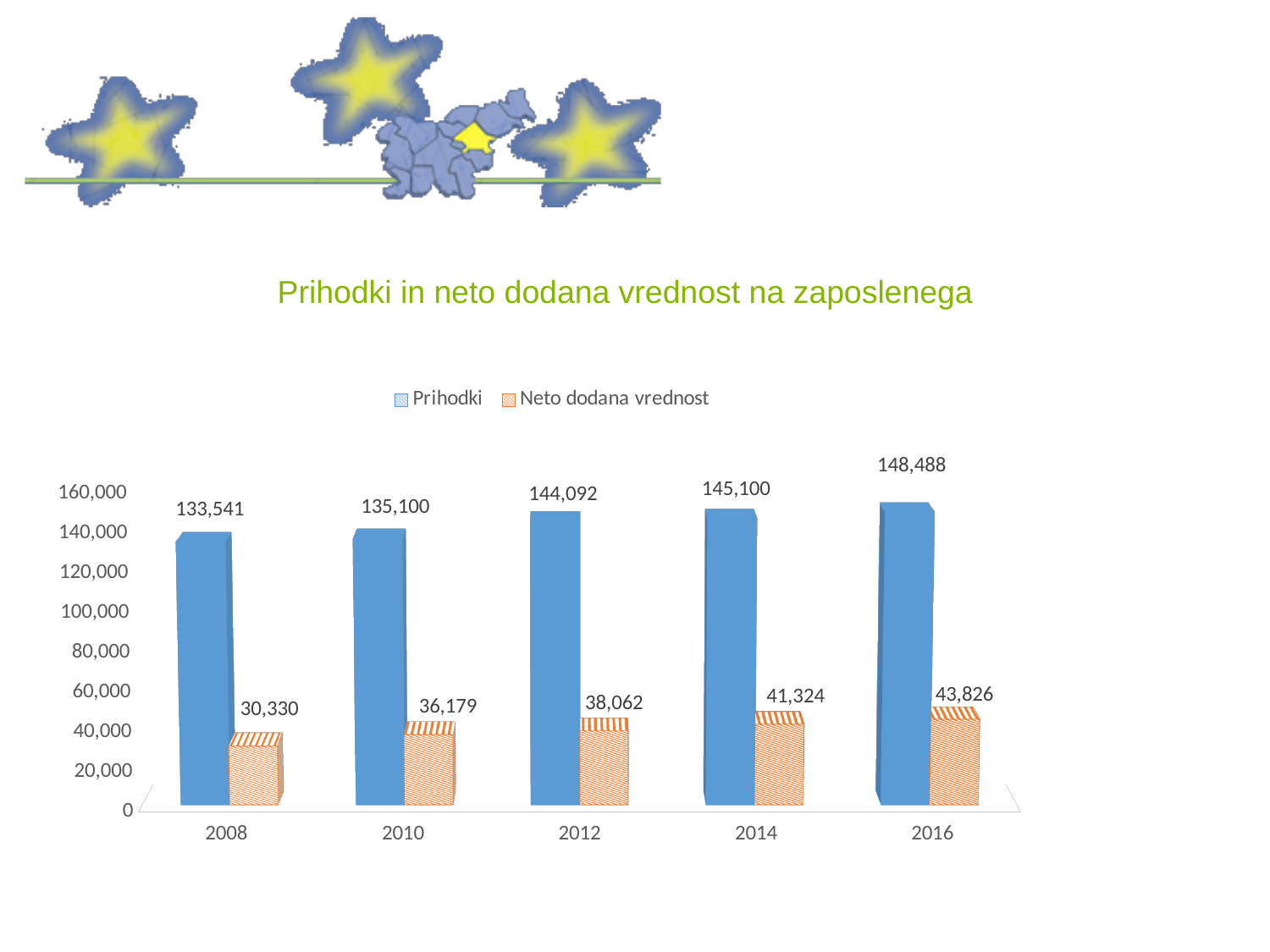
Do the Neto dodana vrednost values rise or fall from 2008 to 2016? Rise Which year has the highest Prihodki value? 2016 How many series does the legend list? 2 What is the Neto dodana vrednost value for 2016? 43,826 What is the Prihodki value for 2012? 144,092 What is the Neto dodana vrednost value for 2008? 30,330 Which is larger, the Prihodki value for 2010 or for 2014? 2014 How many years are shown on the x axis? 5 Which year has the lowest Neto dodana vrednost value? 2008 What kind of chart is shown on the slide? Bar chart What is the difference between the Prihodki values for 2016 and 2008? 14,947 What is the difference between the Neto dodana vrednost values for 2014 and 2012? 3,262